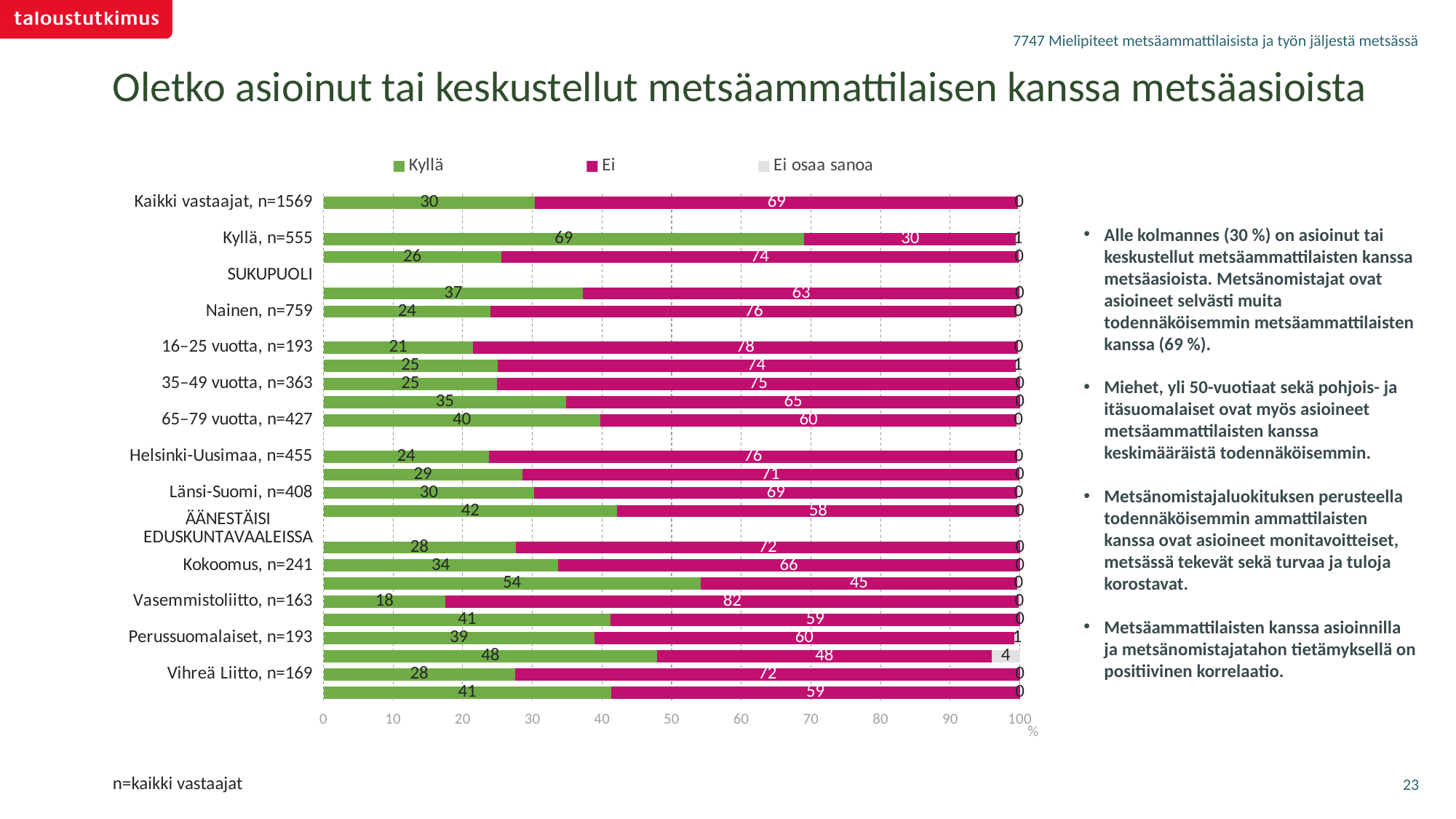
For Kaikki vastaajat, n=1569, how much larger is the Ei value than the Kyllä value? 39 Among the labelled categories, which has the highest Kyllä value? Kyllä, n=555 What are the three legend entries? Kyllä, Ei, Ei osaa sanoa How many series does the legend list? 3 What is the Ei value for Vasemmistoliitto, n=163? 82 Which has a larger Kyllä value: Kokoomus, n=241 or Vihreä Liitto, n=169? Kokoomus, n=241 Among the labelled categories, which has the lowest Kyllä value? Vasemmistoliitto, n=163 What kind of chart is shown on the slide? Stacked bar chart What is the Kyllä value for Kaikki vastaajat, n=1569? 30 What is the total of the stacked bar for Perussuomalaiset, n=193? 100 What is the Ei osaa sanoa value for Perussuomalaiset, n=193? 1 What is the Kyllä value for 65–79 vuotta, n=427? 40